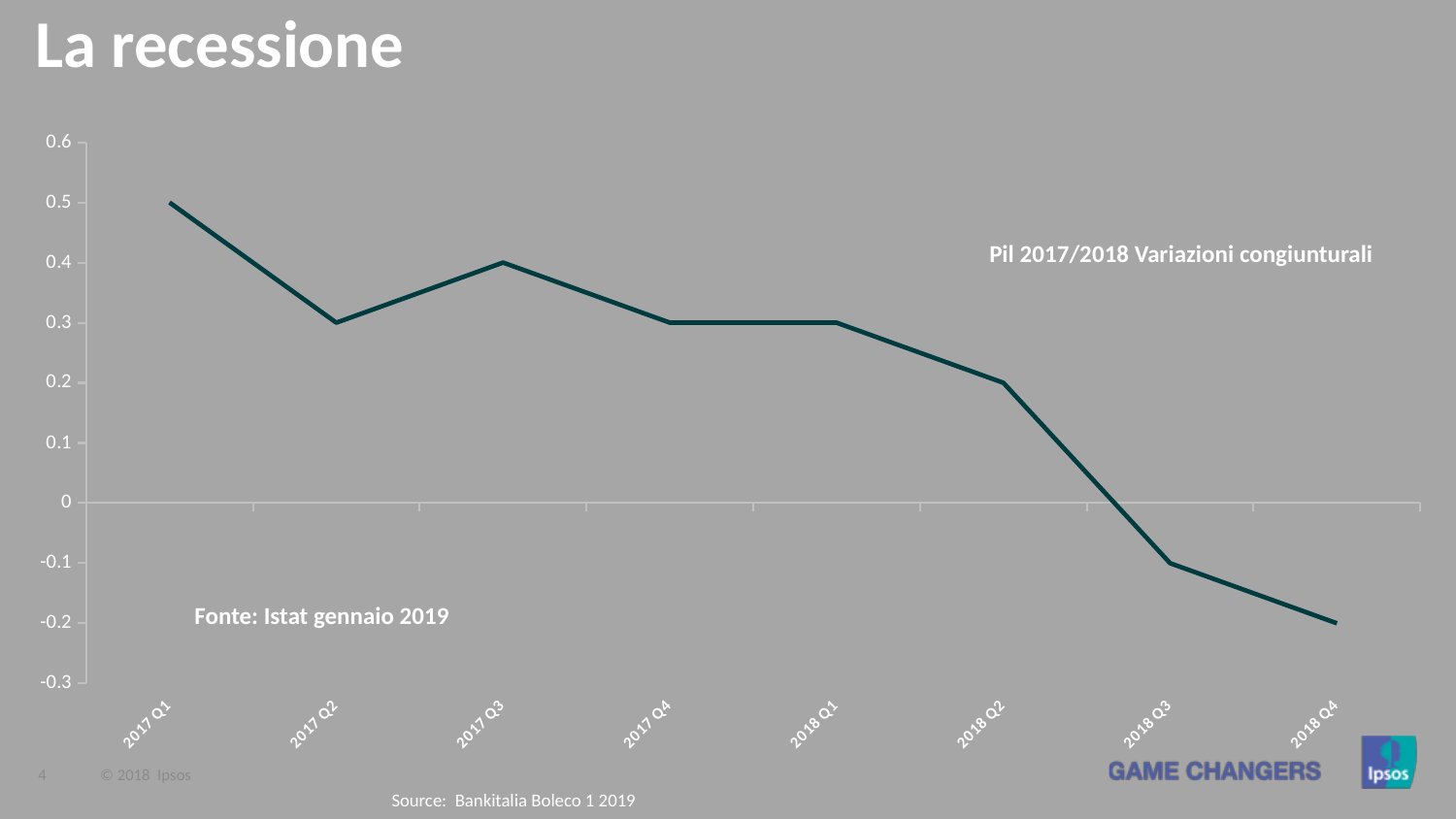
What is the difference between the values for 2017 Q1 and 2018 Q4? 0.7 Which quarter has the highest value? 2017 Q1 Which quarter has the lowest value? 2018 Q4 What kind of chart is shown on the slide? line chart What is the value for 2017 Q1? 0.5 What is the title of the chart? Pil 2017/2018 Variazioni congiunturali Do the values generally rise or fall from 2017 Q1 to 2018 Q4? fall What is the value for 2017 Q3? 0.4 How many quarters are plotted on the x axis? 8 What is the value for 2018 Q4? -0.2 Is the value for 2018 Q3 greater or less than 0? less Which is larger, the value for 2017 Q2 or the value for 2017 Q3? 2017 Q3